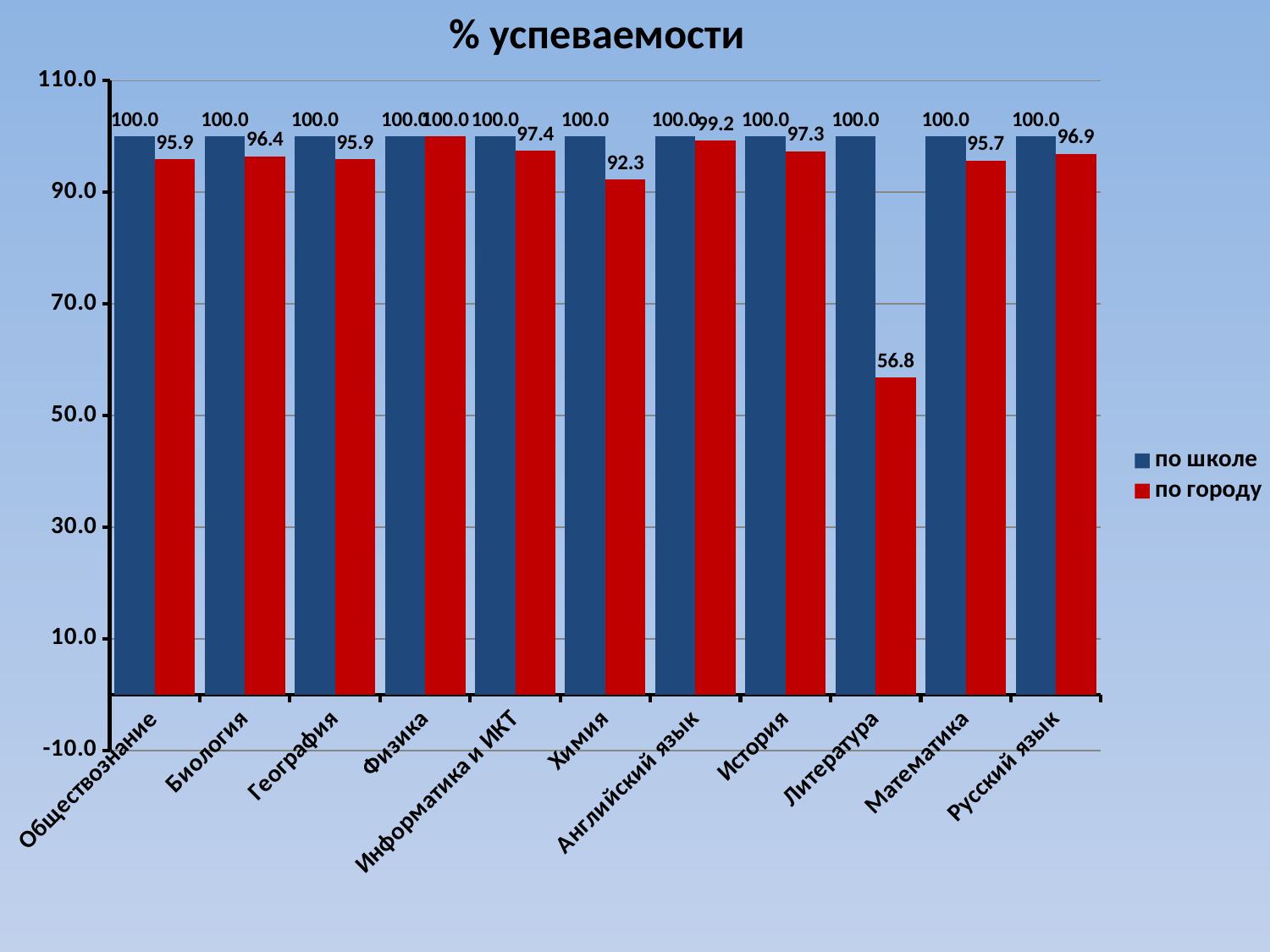
What is the title of the chart? % успеваемости Which category has the highest value for "по городу"? Физика Which is larger for Английский язык: the "по школе" value or the "по городу" value? по школе How many categories are shown on the x axis? 11 What is the value for "по городу" for Литература? 56.8 What is the difference between the "по школе" and "по городу" values for Литература? 43.2 What is the value for "по школе" for Биология? 100.0 Is the value for "по городу" for Литература greater or less than 70.0? less Which category has the lowest value for "по городу"? Литература What is the value for "по городу" for Химия? 92.3 How many series does the legend list? 2 What kind of chart is shown on the slide? bar chart